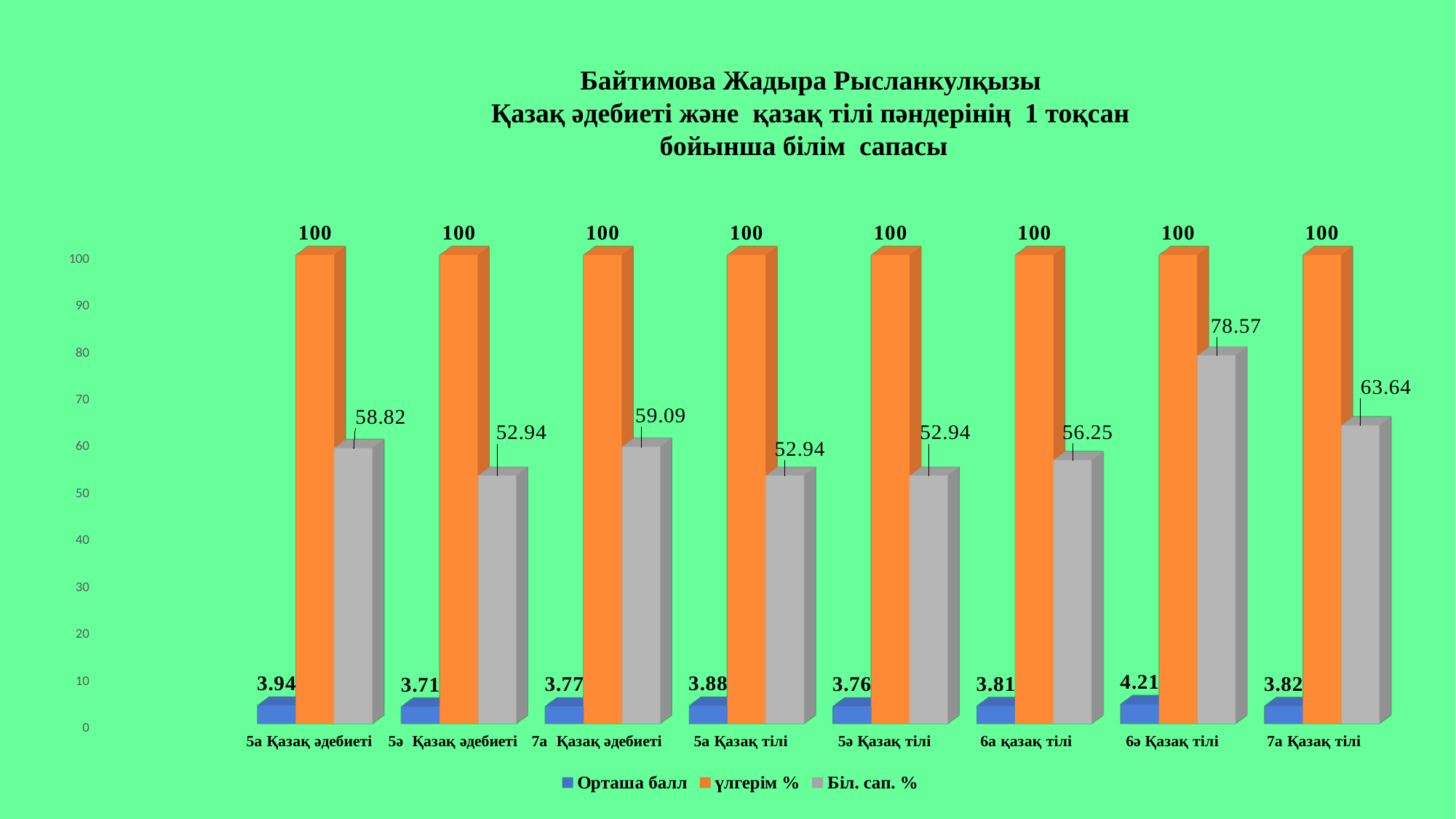
What is the үлгерім % value for 7а Қазақ тілі? 100 How many categories are shown on the x axis? 8 What is the Орташа балл value for 5а Қазақ әдебиеті? 3.94 What is the Біл. сап. % value for 6ә Қазақ тілі? 78.57 What kind of chart is shown on the slide? Bar chart Which series is shown in orange in the legend? үлгерім % Which is larger, the Біл. сап. % value for 5а Қазақ әдебиеті or for 6а қазақ тілі? 5а Қазақ әдебиеті How many series does the legend list? 3 What is the difference between the Біл. сап. % values for 6ә Қазақ тілі and 7а Қазақ тілі? 14.93 Which category has the lowest Орташа балл? 5ә Қазақ әдебиеті Which category has the highest Біл. сап. % value? 6ә Қазақ тілі Which category has the highest Орташа балл? 6ә Қазақ тілі